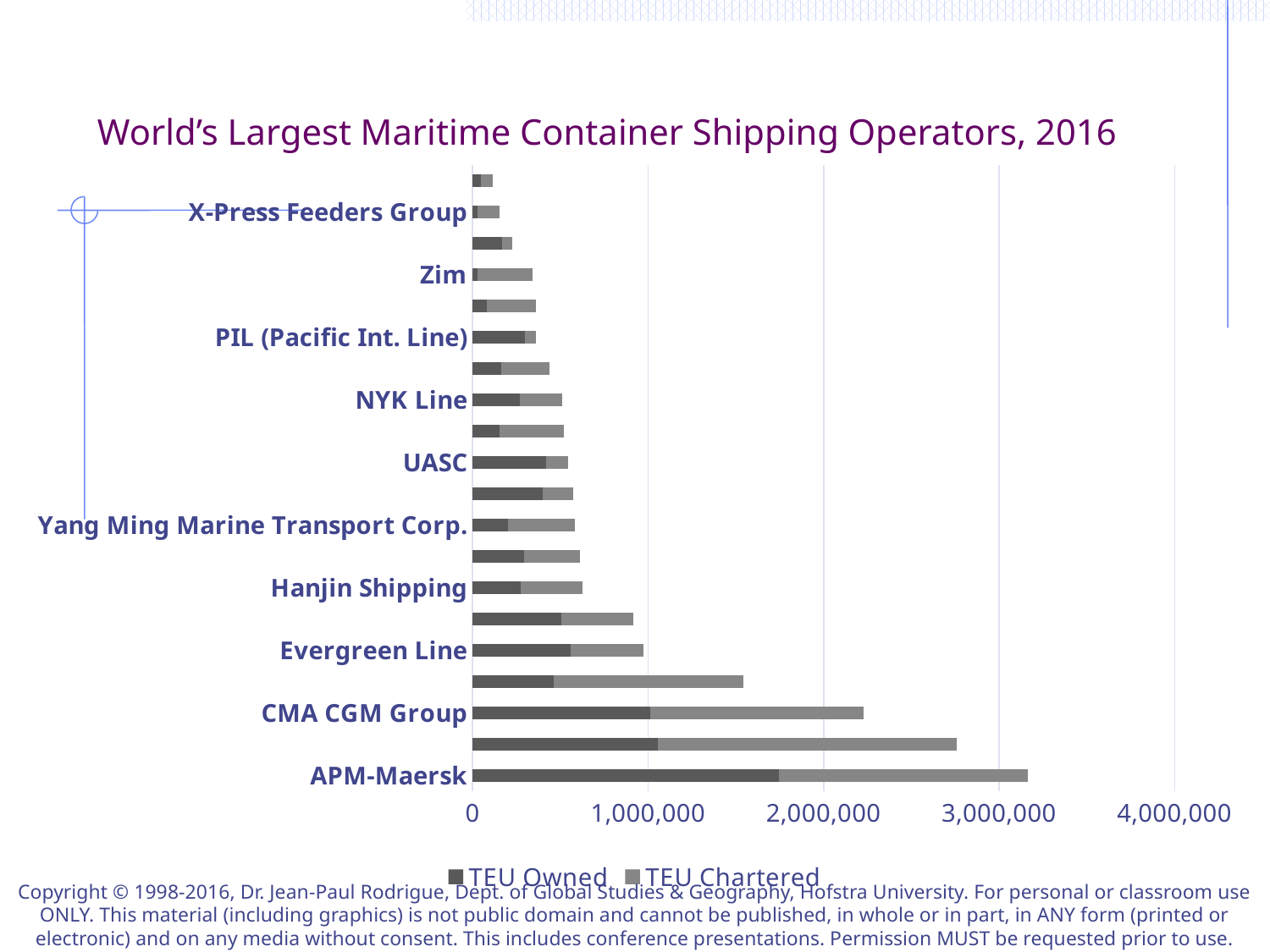
Is the total bar for APM-Maersk greater or less than 3,000,000? greater What is the title of the chart? World's Largest Maritime Container Shipping Operators, 2016 Which labeled operator has the longest total bar? APM-Maersk Is the total bar for CMA CGM Group greater or less than 2,000,000? greater Which labeled operator has the shortest total bar? X-Press Feeders Group What are the two series named in the legend? TEU Owned and TEU Chartered Is the TEU Owned value for APM-Maersk greater or less than 1,000,000? greater What kind of chart is shown on the slide? Stacked bar chart How many series does the legend list? 2 Which has the longer total bar, Evergreen Line or Hanjin Shipping? Evergreen Line Do the total bars get longer or shorter moving from the top of the chart to the bottom? longer